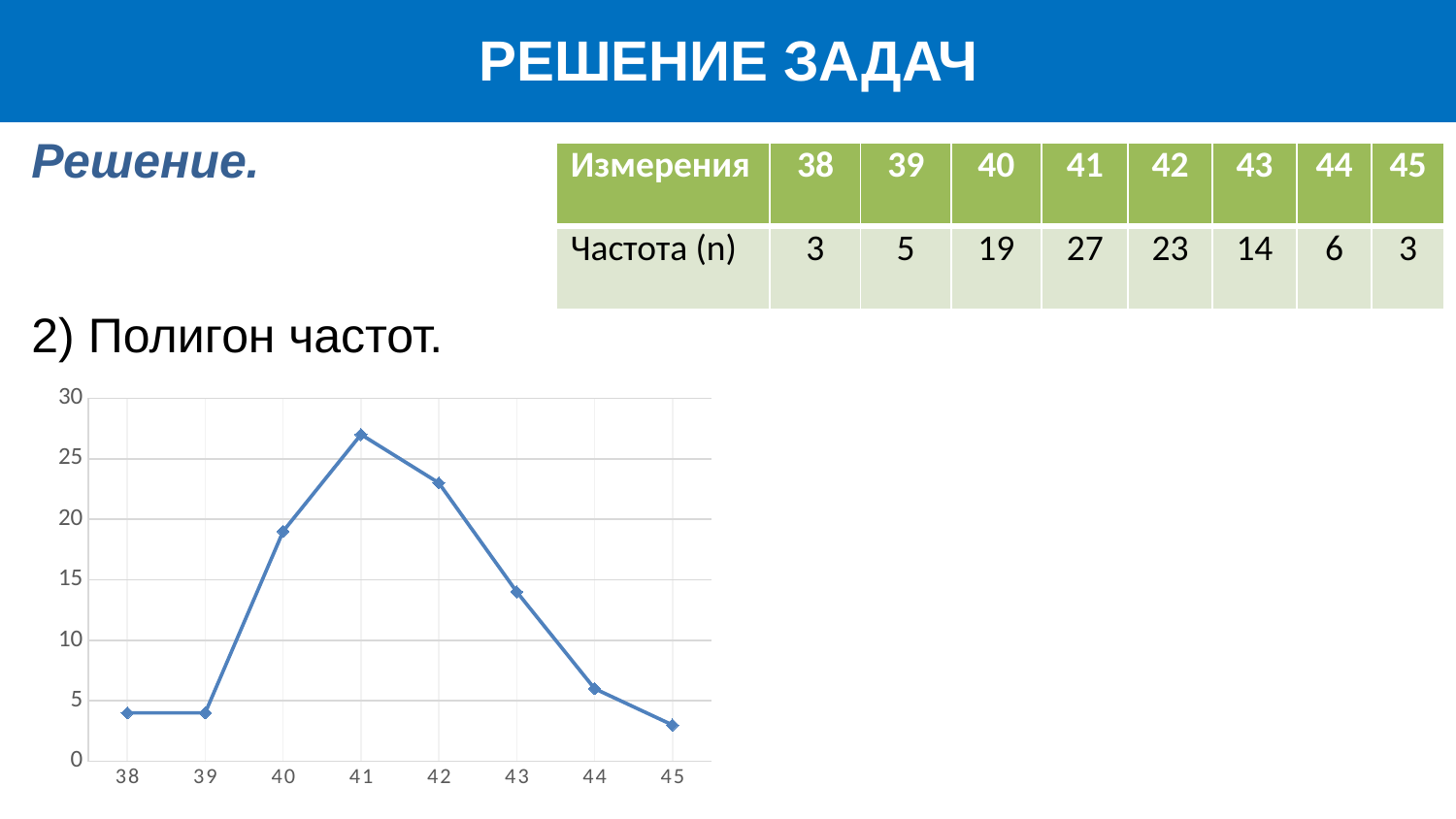
Which has a higher plotted value, 43 or 44? 43 Is the value plotted at 42 greater or less than 20? greater Does the line rise or fall between 41 and 45? fall Which has a higher plotted value, 40 or 42? 42 Does the line rise or fall between 39 and 41? rise What type of chart is shown on the slide? line chart Is the value plotted at 41 greater or less than 25? greater At which measurement value does the frequency polygon reach its highest point? 41 Is the value plotted at 44 greater or less than 10? less How many data points are plotted on the frequency polygon? 8